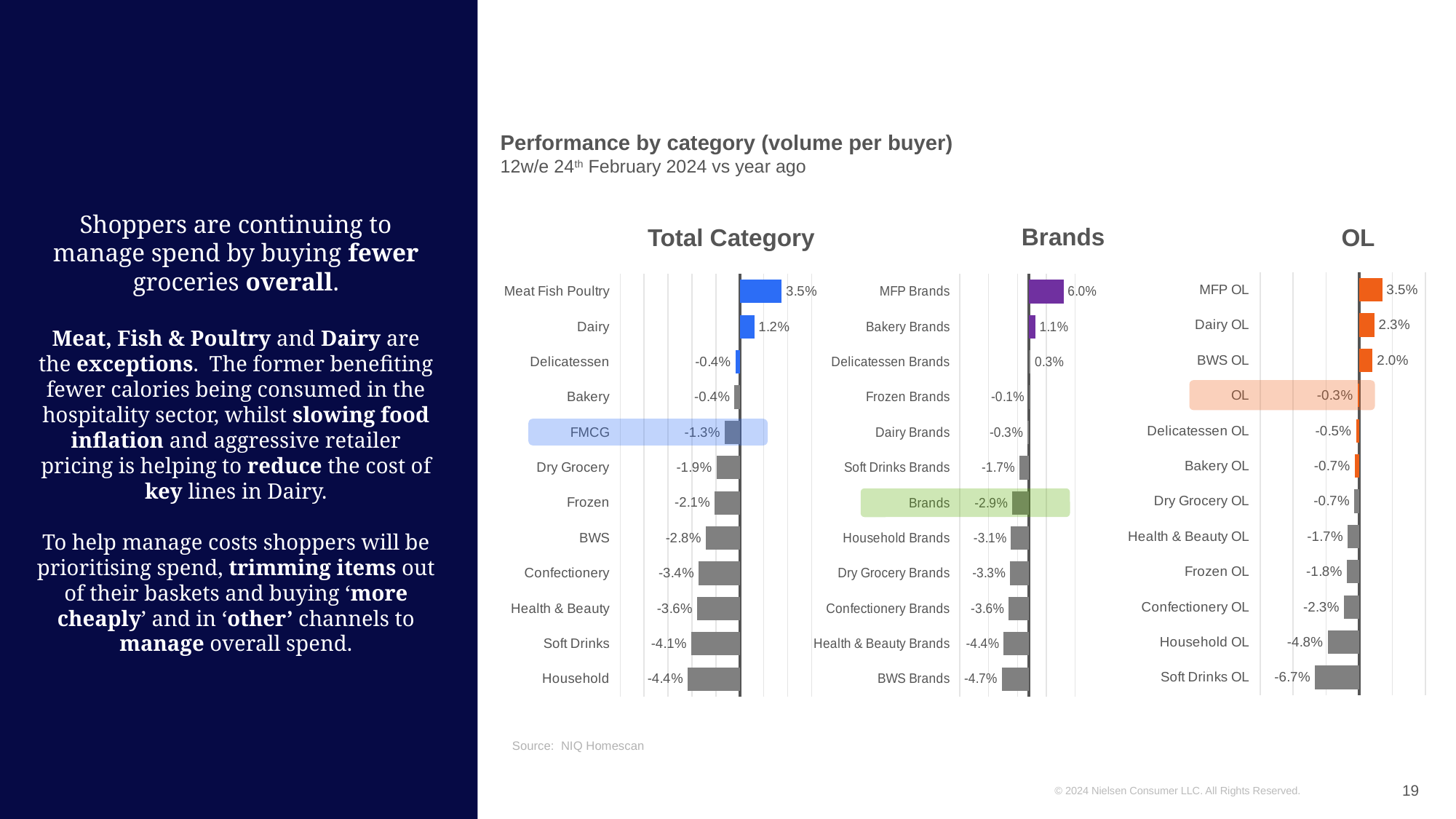
In the Brands chart, what is the value for Brands overall? -2.9% In the Brands chart, which category has the highest value? MFP Brands In the Total Category chart, what is the difference between the values for Meat Fish Poultry and Dairy? 2.3 percentage points In the Brands chart, what is the value for MFP Brands? 6.0% In the OL chart, which is larger, the value for Dairy OL or the value for BWS OL? Dairy OL In the Total Category chart, which category has the lowest value? Household In the Total Category chart, what is the value for FMCG? -1.3% What kind of chart is the Total Category chart? Bar chart How many categories are shown in the Brands chart? 12 In the OL chart, which category has the lowest value? Soft Drinks OL In the Total Category chart, what is the value for Meat Fish Poultry? 3.5% In the OL chart, what is the value for Soft Drinks OL? -6.7%